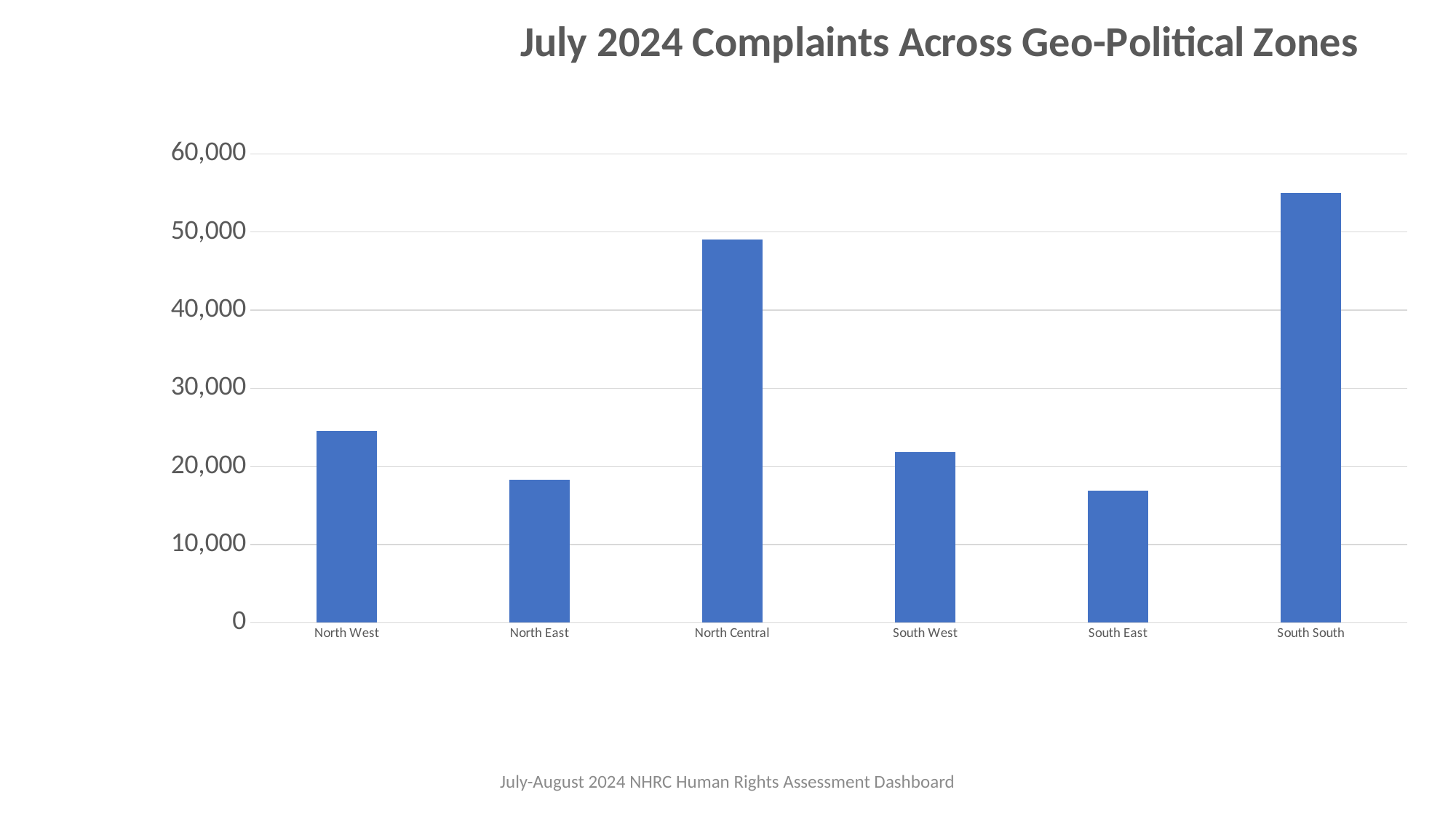
Is the value for North Central greater or less than 50,000? less Is the value for South East greater or less than 20,000? less Which has more complaints, North Central or South South? South South What kind of chart is shown on the slide? bar chart Which has more complaints, North West or South West? North West Is the value for North East greater or less than 20,000? less Which zone has the lowest number of complaints? South East What is the title of the chart? July 2024 Complaints Across Geo-Political Zones How many geo-political zones are shown on the x axis? 6 Which zone has the highest number of complaints? South South